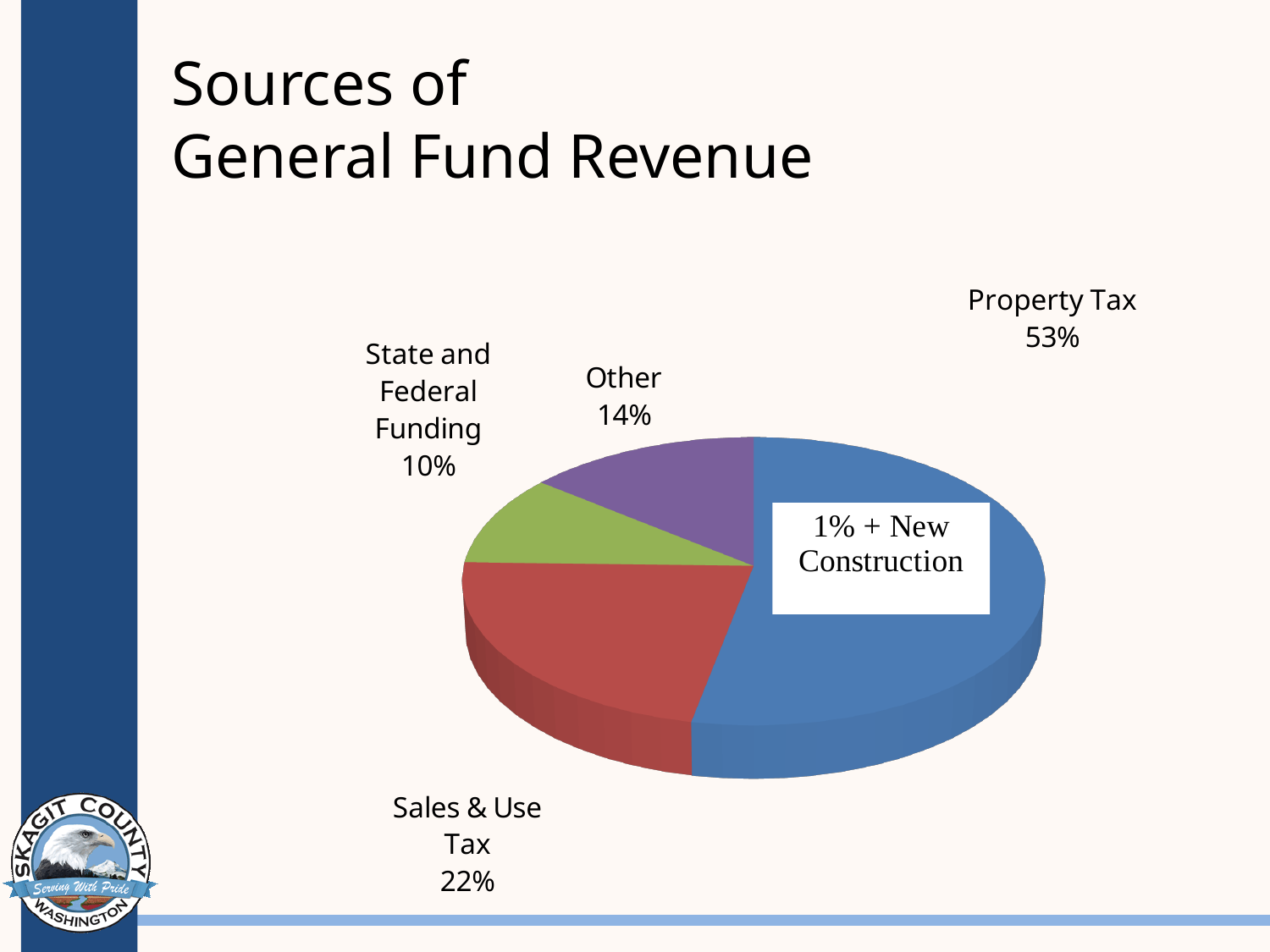
How many percentage points larger is the Property Tax share than the Sales & Use Tax share? 31 percentage points Which source makes up the smallest share of General Fund Revenue? State and Federal Funding What share of General Fund Revenue comes from Other? 14% Which source makes up the largest share of General Fund Revenue? Property Tax Which is larger: the share for Other or the share for State and Federal Funding? Other What text appears in the box overlaid on the Property Tax slice? 1% + New Construction What is the title of the slide containing the chart? Sources of General Fund Revenue What share of General Fund Revenue comes from Property Tax? 53% What kind of chart is shown on the slide? Pie chart How many sources of revenue are shown in the pie chart? 4 What share of General Fund Revenue comes from State and Federal Funding? 10% What share of General Fund Revenue comes from Sales & Use Tax? 22%